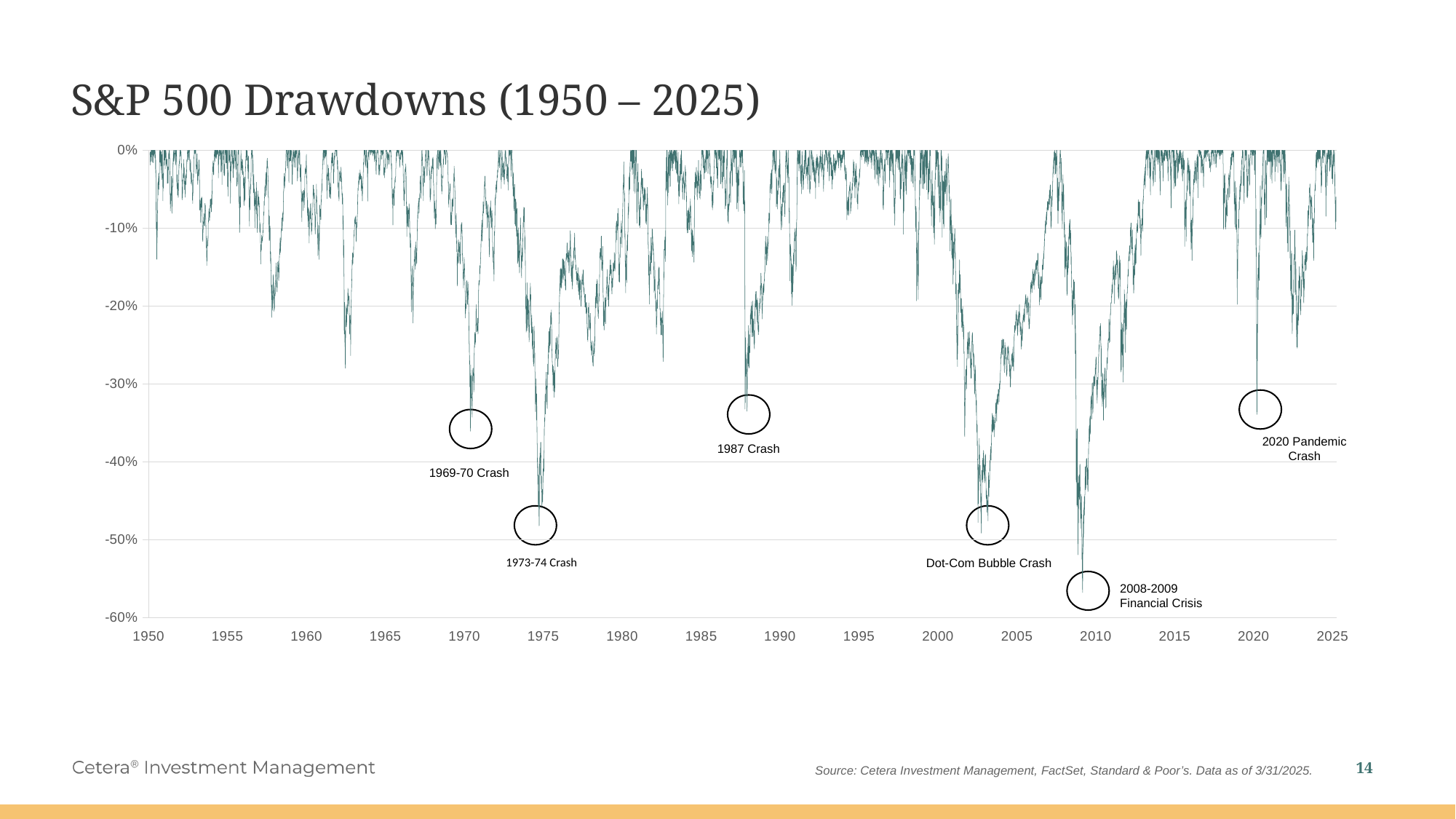
What kind of chart is shown on the slide? line chart How many crashes are circled and labelled on the chart? 6 Is the drawdown value at the 2008-2009 Financial Crisis greater or less than -50%? less Is the drawdown value at the 2020 Pandemic Crash greater or less than -40%? greater Is the drawdown value at the 1987 Crash greater or less than -30%? less What is the title of the chart? S&P 500 Drawdowns (1950 – 2025) Which drawdown was deeper, the Dot-Com Bubble Crash or the 2008-2009 Financial Crisis? 2008-2009 Financial Crisis What is the lowest value shown on the vertical axis? -60% Which labelled crash shows the deepest drawdown? 2008-2009 Financial Crisis Which drawdown was deeper, the 1973-74 Crash or the 1987 Crash? 1973-74 Crash